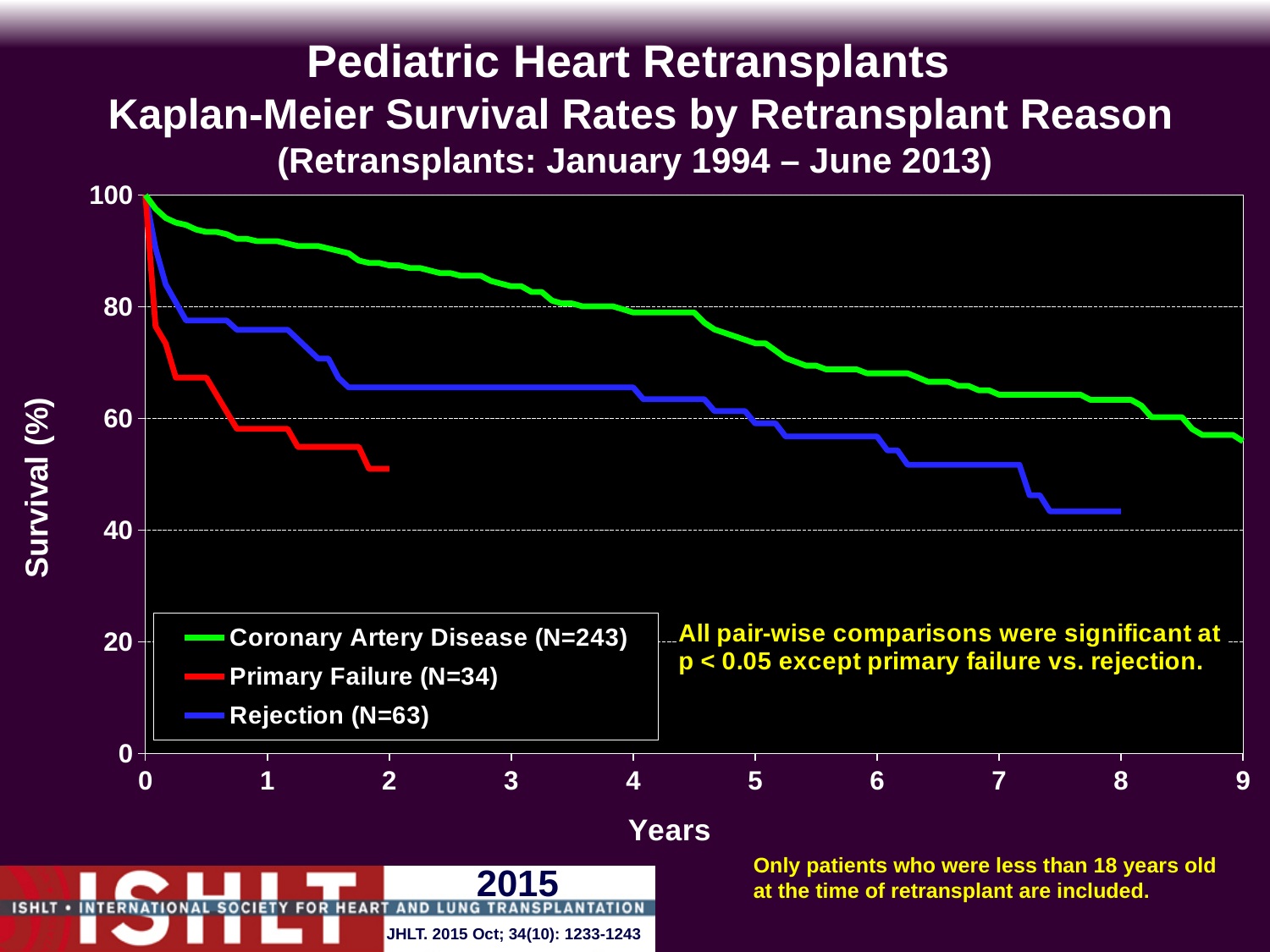
Is the survival for Coronary Artery Disease at 4 years greater or less than 60? greater At 4 years, which is higher: survival for Coronary Artery Disease or for Rejection? Coronary Artery Disease Which retransplant reason has the lowest survival curve? Primary Failure What kind of chart is shown on the slide? line chart What is the N for the Rejection group shown in the legend? 63 Which retransplant reason has the highest survival curve across the chart? Coronary Artery Disease What is the survival (%) for all three groups at year 0? 100 Is the survival for Primary Failure at 2 years greater or less than 60? less Do the survival curves rise or fall as years increase? fall Is the survival for Rejection at 8 years greater or less than 60? less How many series does the legend list? 3 Which series is plotted with the green line? Coronary Artery Disease (N=243)